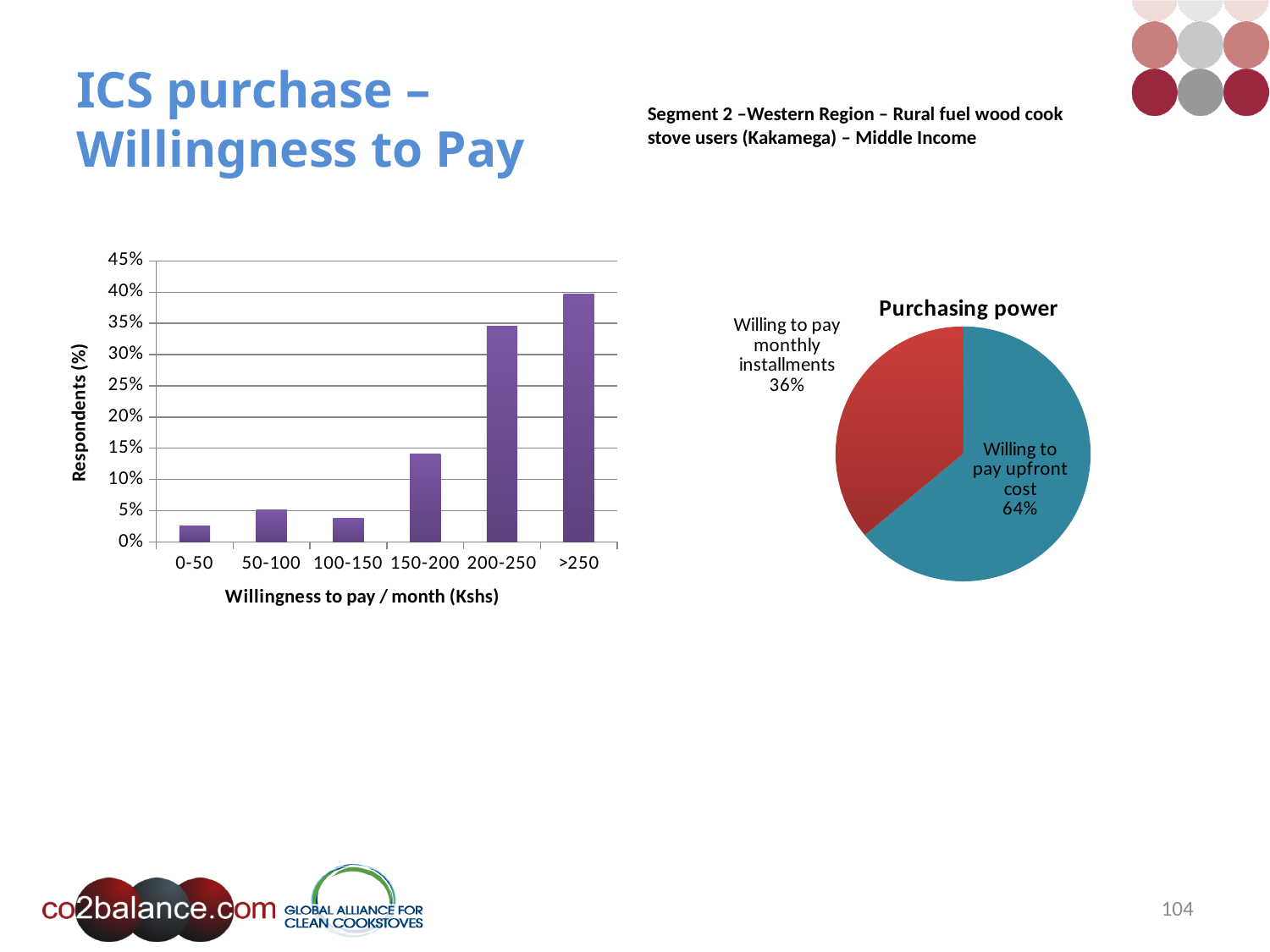
In the 'Purchasing power' pie chart, what share of respondents are willing to pay the upfront cost? 64% In the bar chart on the left, is the value for the 0-50 category greater or less than 5%? less How many willingness-to-pay categories are shown on the x axis of the bar chart on the left? 6 In the bar chart on the left, which willingness-to-pay category has the highest share of respondents? >250 In the bar chart on the left, which is larger: the value for 150-200 or the value for 50-100? 150-200 In the bar chart on the left, is the value for the 200-250 category greater or less than 30%? greater In the bar chart on the left, is the value for the 150-200 category greater or less than 10%? greater In the bar chart on the left, do the values generally rise or fall from the 100-150 category to the >250 category? rise What kind of chart is the chart on the left of the slide? bar chart What is the x-axis label of the bar chart on the left? Willingness to pay / month (Kshs) In the 'Purchasing power' pie chart, how many percentage points larger is the 'Willing to pay upfront cost' slice than the 'Willing to pay monthly installments' slice? 28 percentage points In the 'Purchasing power' pie chart, what share of respondents are willing to pay monthly installments? 36%